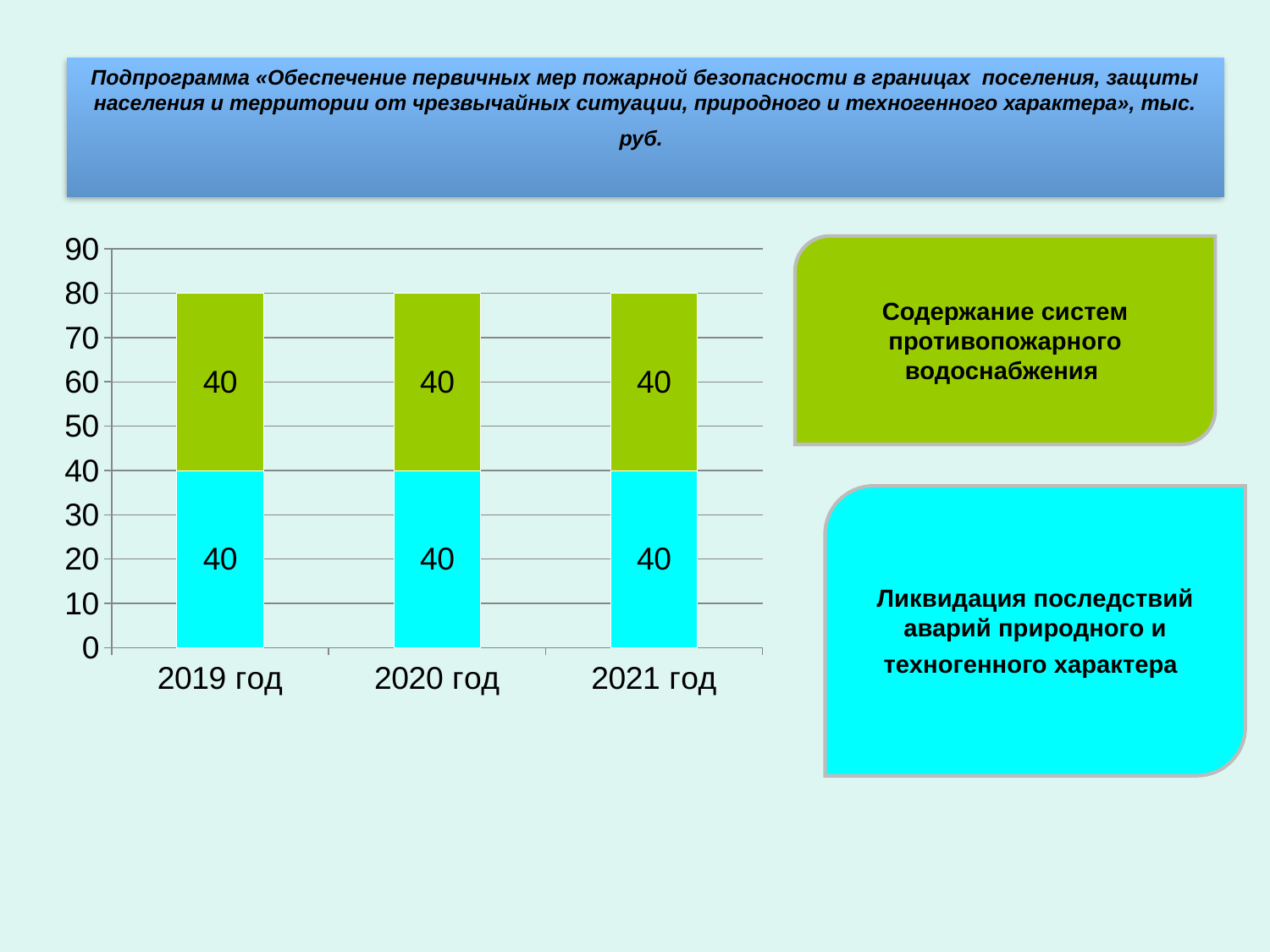
Which colour represents «Ликвидация последствий аварий природного и техногенного характера» in the chart? Cyan (light blue) What is the difference between the two segments of the bar for 2021 год? 0 What is the total of the stacked bar for 2019 год? 80 How many years are shown on the x axis of the chart? 3 What is the value for «Содержание систем противопожарного водоснабжения» in 2020 год? 40 What kind of chart is shown on the slide? Stacked bar chart Is the total of the stacked bar for 2021 год greater or less than 70? greater What is the value for «Ликвидация последствий аварий природного и техногенного характера» in 2021 год? 40 Do the total values of the bars rise, fall or stay the same from 2019 год to 2021 год? Stay the same What is the value for «Содержание систем противопожарного водоснабжения» in 2019 год? 40 In what units are the values in the chart expressed, according to the slide title? тыс. руб. What is the total of the stacked bar for 2020 год? 80